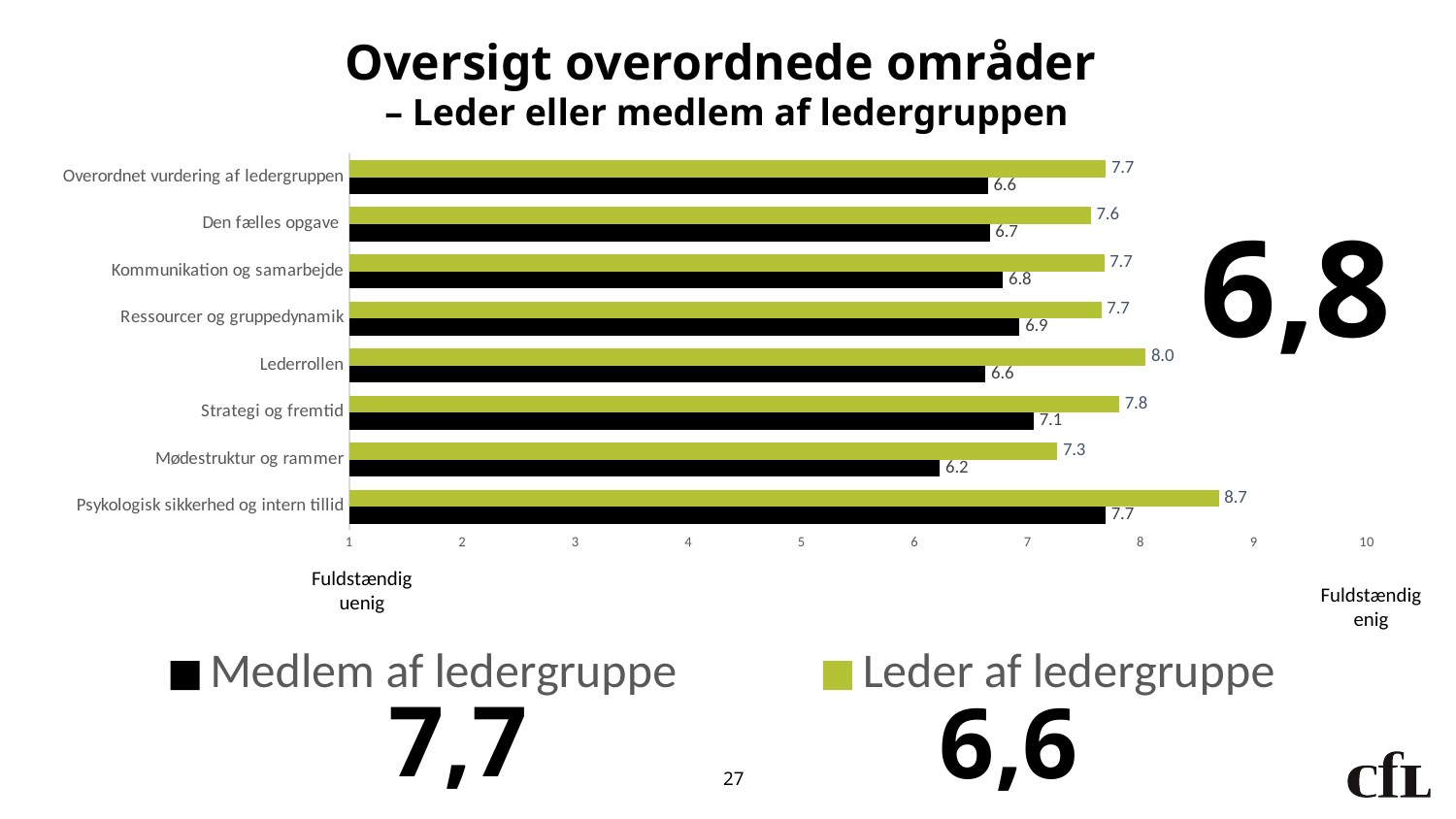
How many categories are shown on the chart? 8 What is the value for Medlem af ledergruppe in the category Strategi og fremtid? 7.1 Which category has the highest value for Leder af ledergruppe? Psykologisk sikkerhed og intern tillid Which category has the lowest value for Medlem af ledergruppe? Mødestruktur og rammer What is the difference between the Leder af ledergruppe and Medlem af ledergruppe values for Lederrollen? 1.4 Is the value for Medlem af ledergruppe in Kommunikation og samarbejde greater or less than 7? less What is the value for Medlem af ledergruppe in the category Mødestruktur og rammer? 6.2 Which is larger for Den fælles opgave: the value for Leder af ledergruppe or for Medlem af ledergruppe? Leder af ledergruppe What kind of chart is shown on the slide? Bar chart How many series does the legend list? 2 Which colour represents Leder af ledergruppe in the chart? Green What is the value for Leder af ledergruppe in the category Psykologisk sikkerhed og intern tillid? 8.7